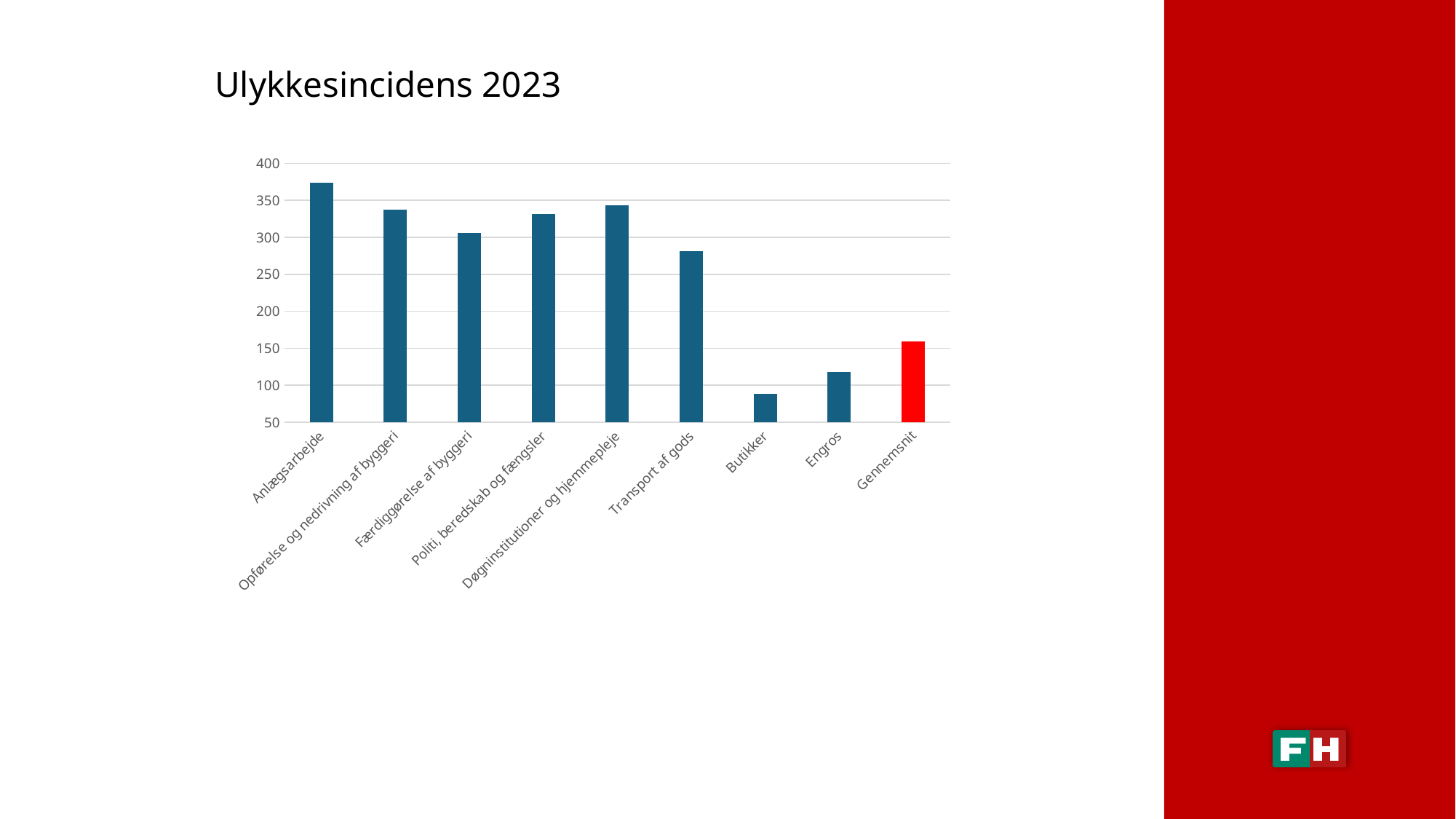
What is the title of the chart? Ulykkesincidens 2023 Which bar is shown in a different colour (red) from the others? Gennemsnit Is the value for Butikker greater or less than 100? less Which category has the lowest value? Butikker Is the value for Gennemsnit greater or less than 150? greater What kind of chart is shown on the slide? bar chart Is the value for Transport af gods greater or less than 300? less Which is larger, the value for Engros or the value for Butikker? Engros Which category has the highest value? Anlægsarbejde How many categories are plotted on the x axis? 9 Which is larger, the value for Gennemsnit or the value for Transport af gods? Transport af gods